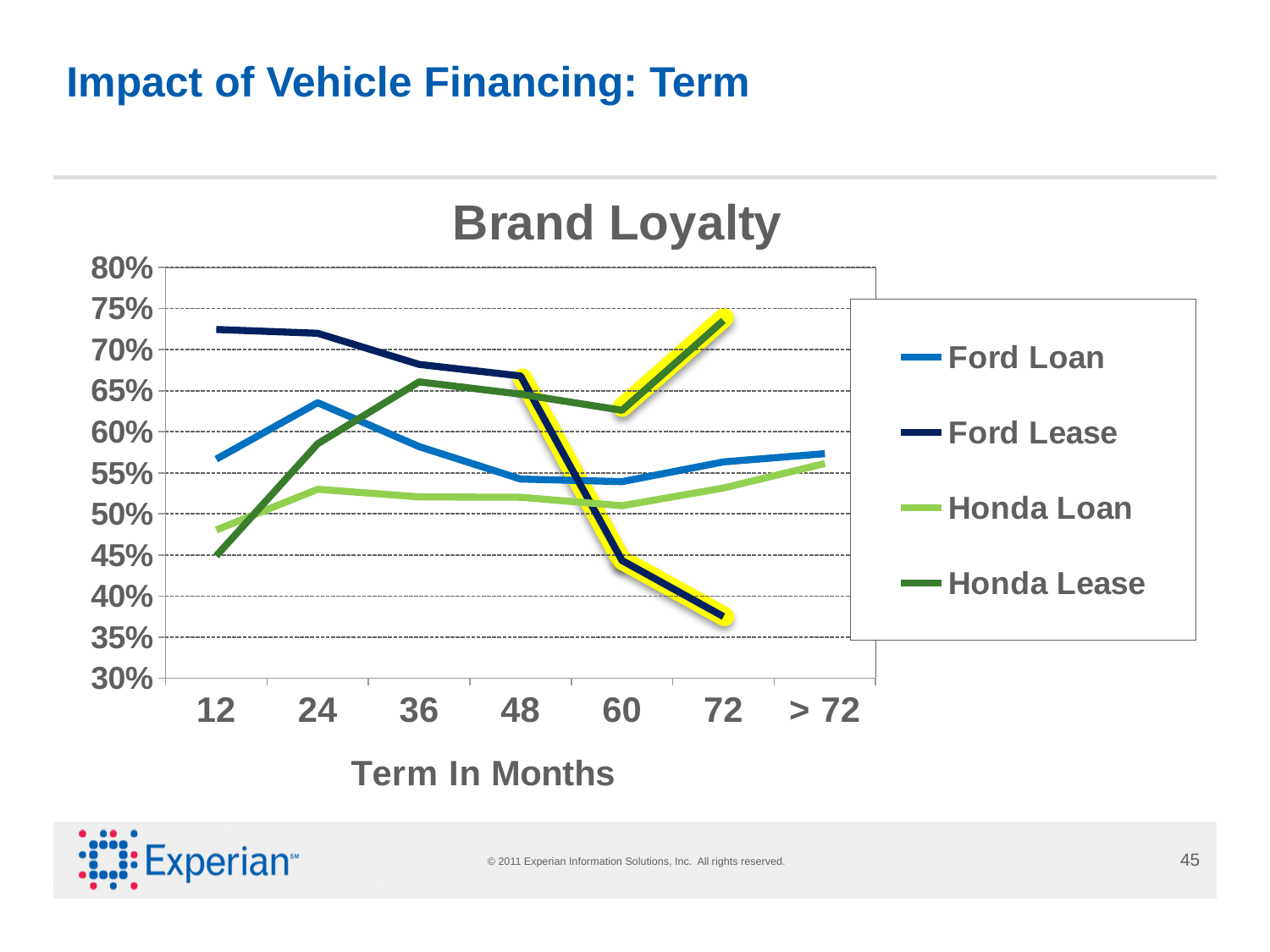
Does the Ford Lease line rise or fall from 48 months to 72 months? fall What kind of chart is shown on the slide? line chart Is the value for Ford Lease at 72 months greater or less than 40%? less Which series has the lowest value at 72 months? Ford Lease How many term categories are shown on the x axis? 7 What is the title of the x axis? Term In Months Which series has the highest value at 12 months? Ford Lease At 72 months, which is larger: Honda Lease or Ford Lease? Honda Lease Is the value for Honda Lease at 12 months greater or less than 50%? less How many series does the legend list? 4 At 12 months, which is larger: Ford Lease or Honda Lease? Ford Lease Is the value for Ford Lease at 12 months greater or less than 70%? greater